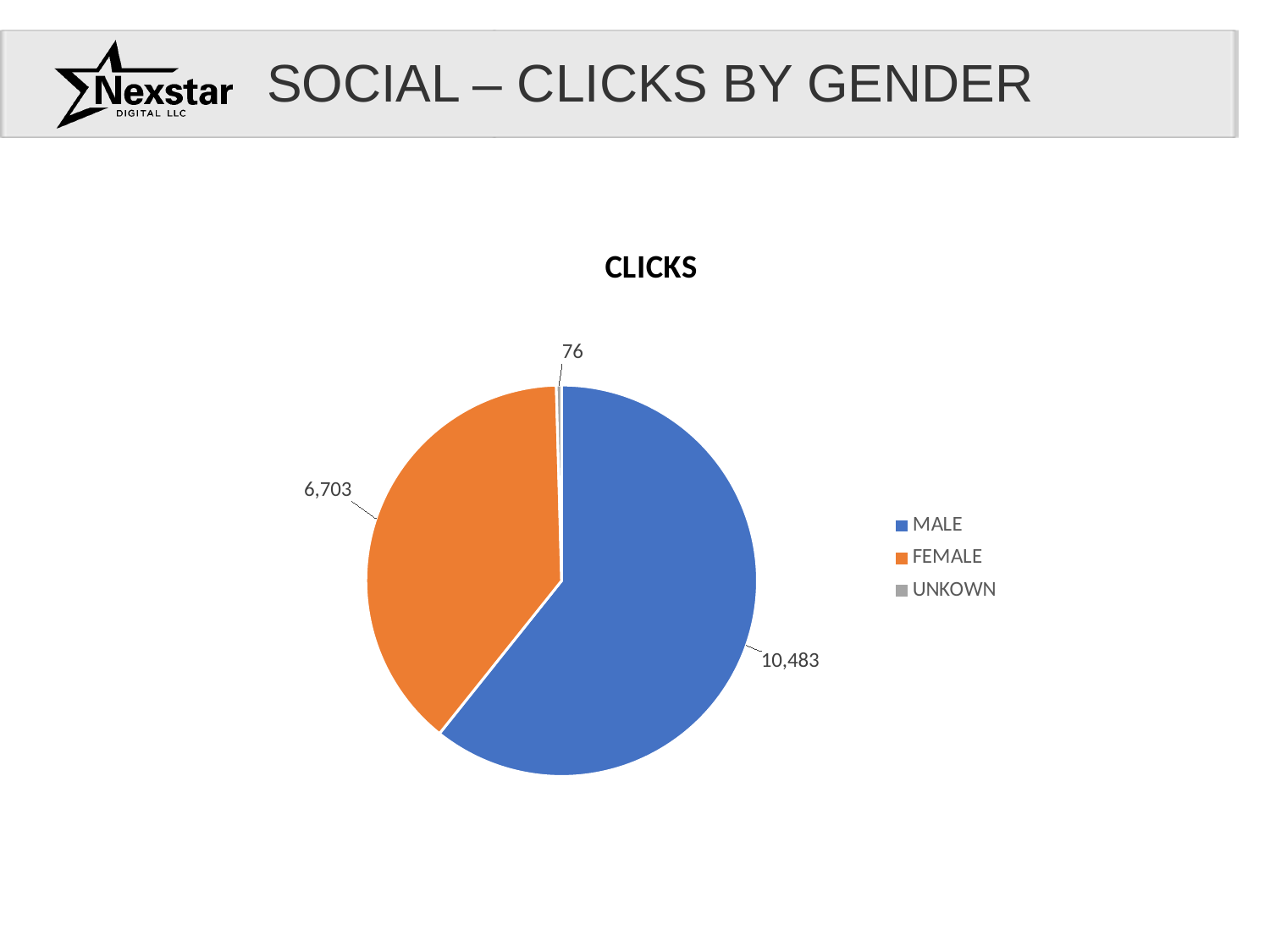
Which category has the smallest share of clicks? UNKOWN What is the number of clicks for UNKOWN? 76 What is the number of clicks for FEMALE? 6,703 What is the number of clicks for MALE? 10,483 Which has more clicks, FEMALE or UNKOWN? FEMALE What is the total number of clicks across all categories? 17,262 What type of chart is shown on the slide? Pie chart Which category has the largest share of clicks? MALE What share of total clicks does MALE represent, to one decimal place? 60.7% What is the title of the chart? CLICKS How many slices does the pie chart have? 3 What is the difference in clicks between MALE and FEMALE? 3,780